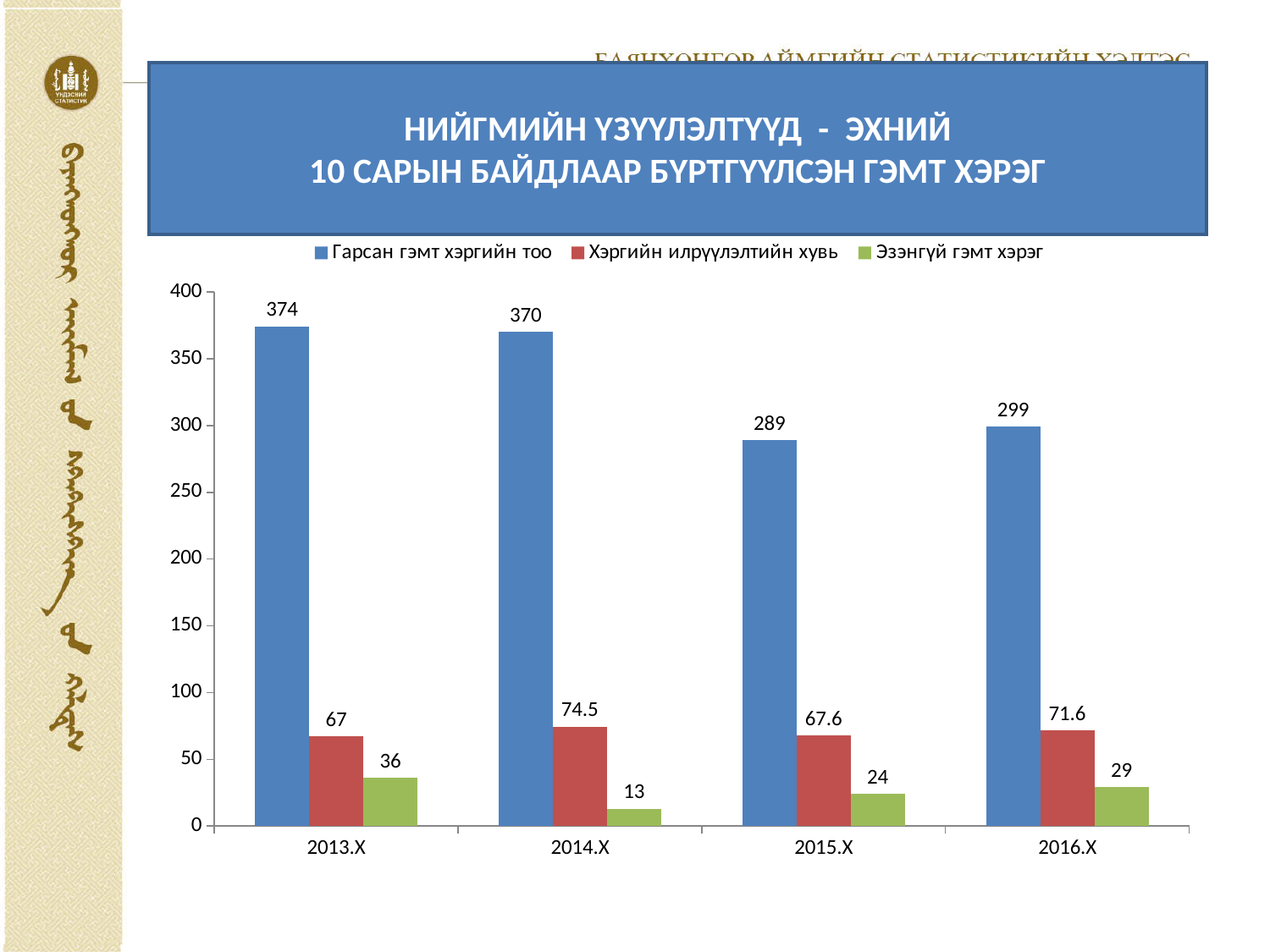
What is the difference between the Гарсан гэмт хэргийн тоо values for 2013.X and 2016.X? 75 What kind of chart is shown on the slide? bar chart Which year has the lowest value for Гарсан гэмт хэргийн тоо? 2015.X Which is larger: Хэргийн илрүүлэлтийн хувь for 2014.X or for 2016.X? 2014.X How many years are shown on the x axis? 4 What is the value of Эзэнгүй гэмт хэрэг for 2015.X? 24 How many series does the legend list? 3 Which year has the highest value for Эзэнгүй гэмт хэрэг? 2013.X Which colour represents Эзэнгүй гэмт хэрэг in the legend? green Is the value of Гарсан гэмт хэргийн тоо for 2016.X greater or less than 350? less What is the value of Гарсан гэмт хэргийн тоо for 2013.X? 374 What is the value of Хэргийн илрүүлэлтийн хувь for 2014.X? 74.5